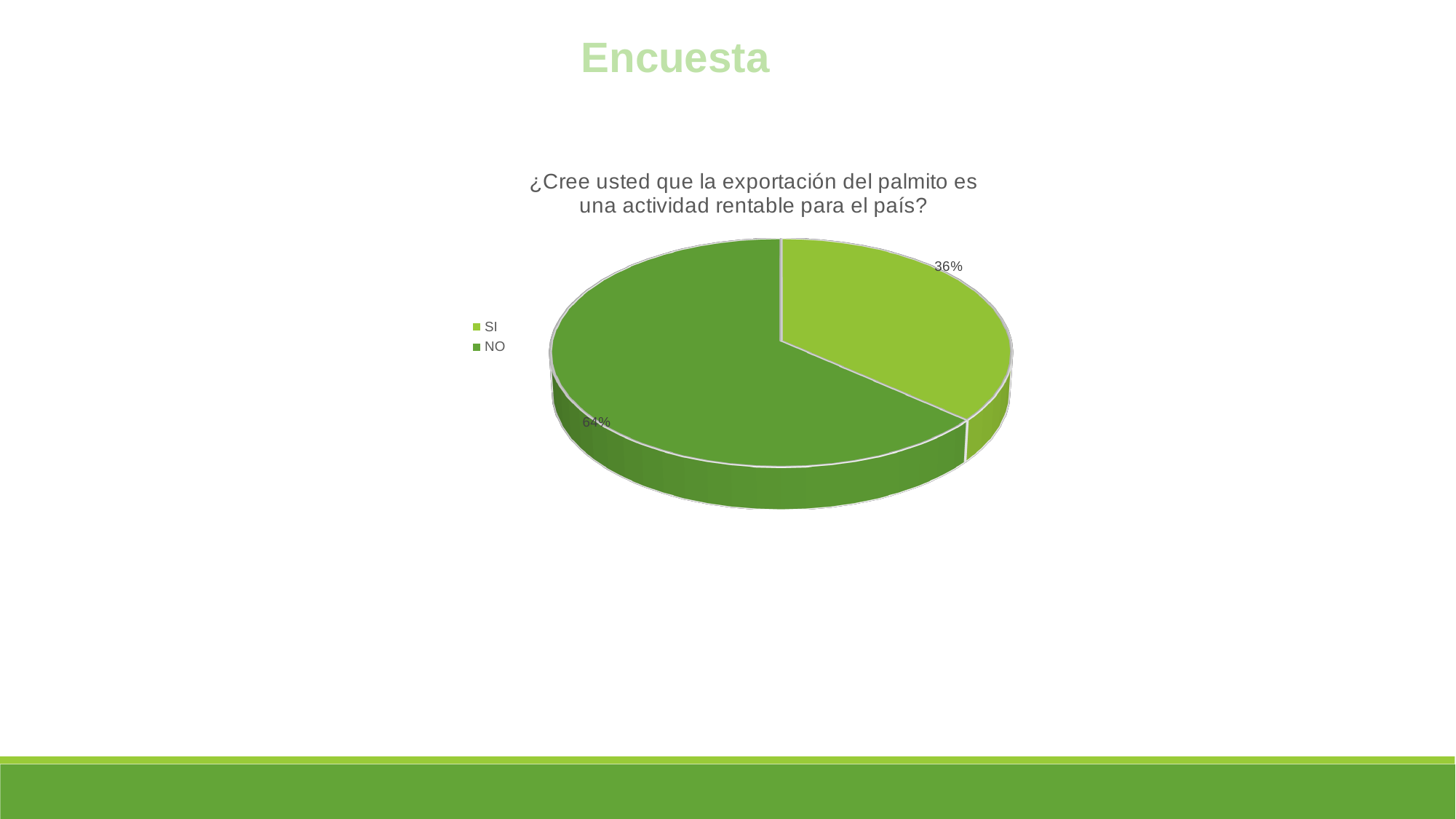
Which is larger, the SI slice or the NO slice? NO What percentage of respondents answered SI? 36% How many categories does the pie chart show? 2 What is the title of the chart? ¿Cree usted que la exportación del palmito es una actividad rentable para el país? What share of the pie does the SI slice represent? 36% What type of chart is shown on the slide? Pie chart How many entries does the legend list? 2 Which legend entry is shown in the lighter green colour? SI What percentage of respondents answered NO? 64% Which response has the smallest share of the pie? SI Which response has the largest share of the pie? NO What is the difference in percentage points between the NO and SI slices? 28